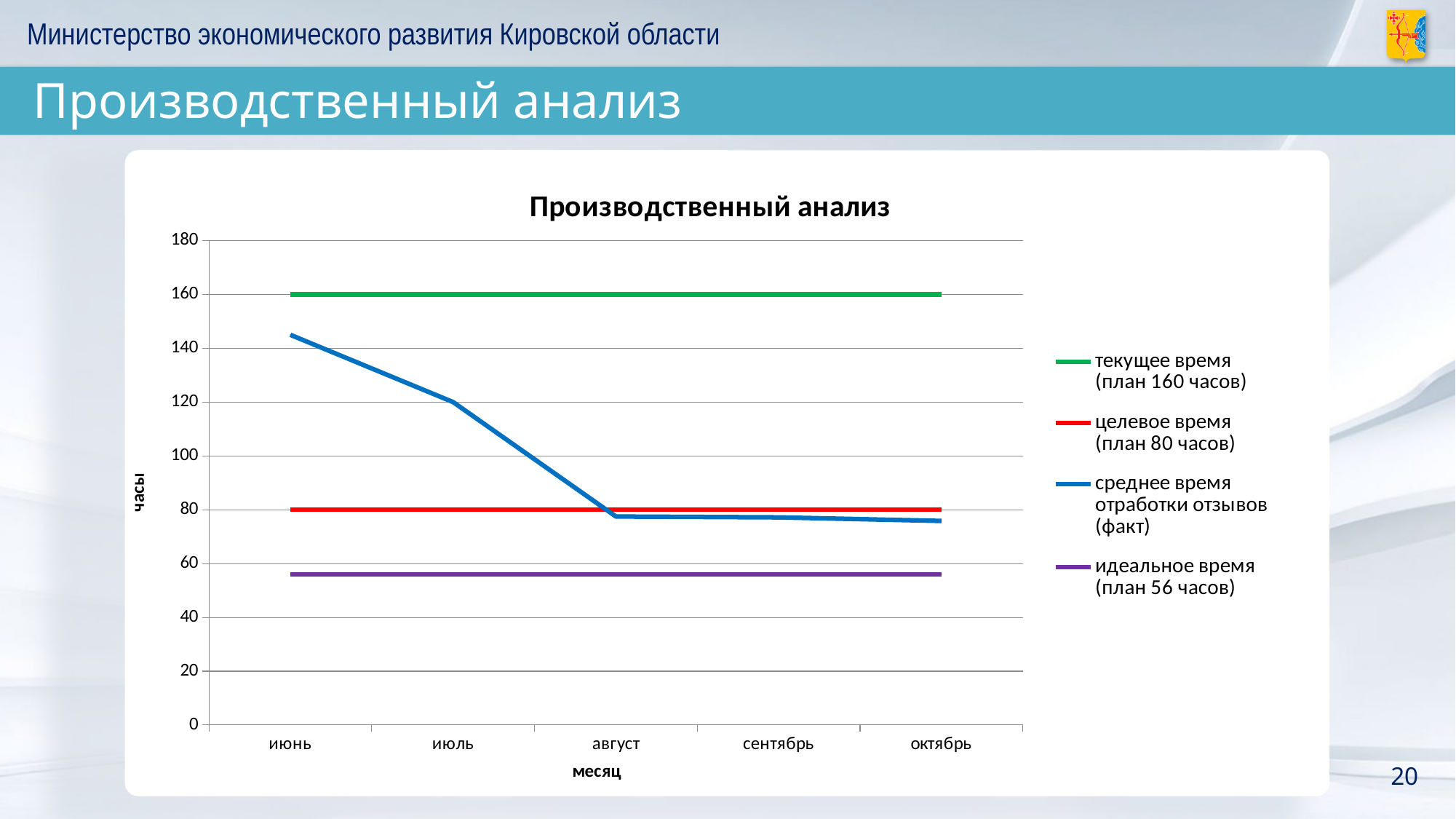
What is the difference between the текущее время plan line and the целевое время plan line? 80 What type of chart is shown on the slide? line chart What value does the целевое время line sit at? 80 How many series does the legend list? 4 What value does the текущее время line sit at? 160 Is the value for среднее время отработки отзывов (факт) in октябрь greater or less than 60? greater Does the line for среднее время отработки отзывов (факт) rise or fall from июнь to октябрь? fall How many months are shown on the x axis? 5 Which month has the highest value for среднее время отработки отзывов (факт)? июнь Is the value for среднее время отработки отзывов (факт) in август greater or less than 100? less Is the value for среднее время отработки отзывов (факт) in июнь greater or less than 140? greater Which is larger for среднее время отработки отзывов (факт): июнь or июль? июнь